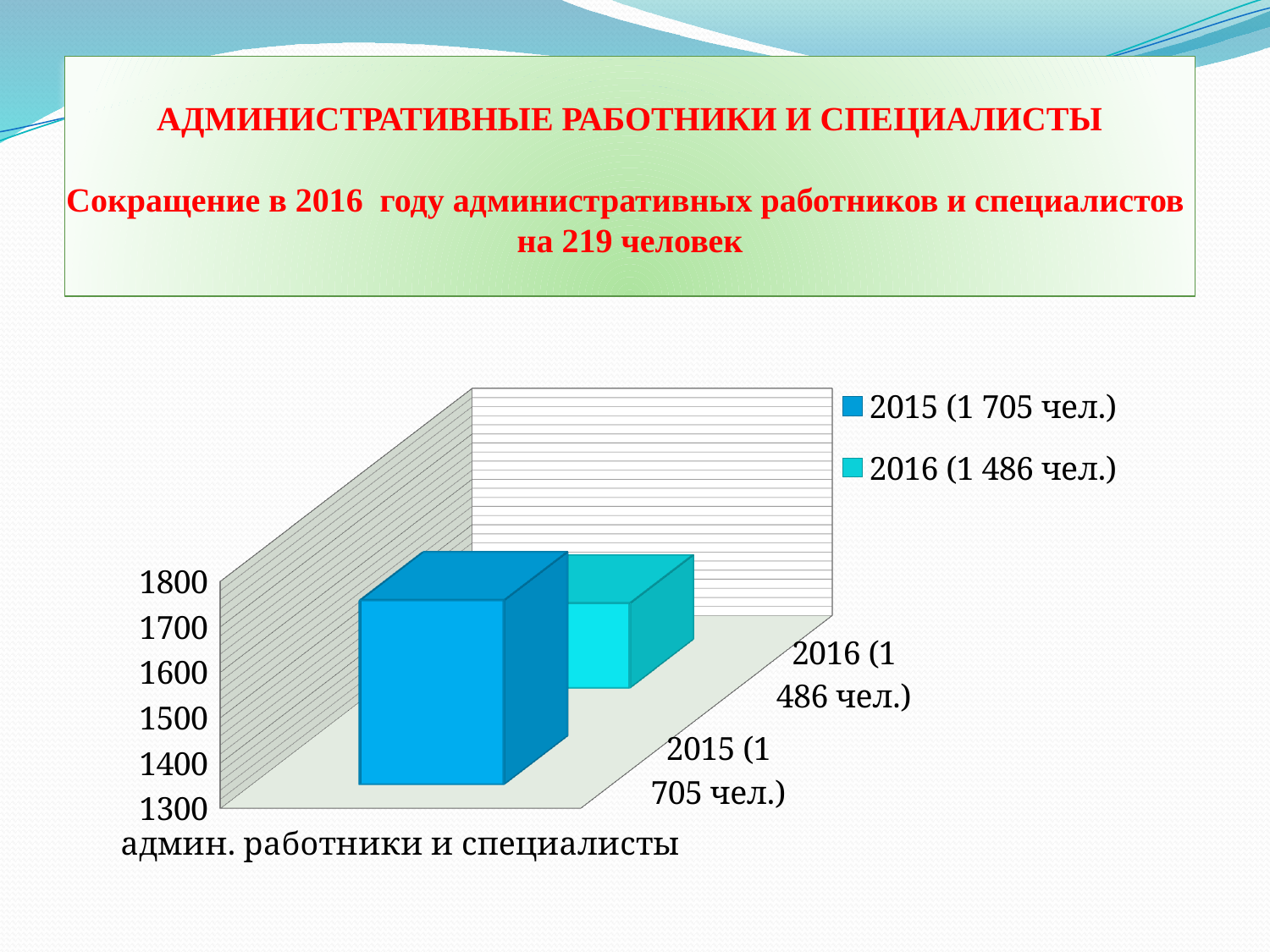
How many series does the chart legend list? 2 Is the value for 2015 greater or less than 1600? greater Which year has the higher value, 2015 or 2016? 2015 According to the legend, how many people were there in 2016? 1 486 чел. What is the lowest value shown on the vertical axis of the chart? 1300 What kind of chart is shown on the slide? bar chart By how many people did the number decrease from 2015 to 2016? 219 According to the legend, how many people were there in 2015? 1 705 чел. How many categories are shown on the x axis of the chart? 1 Which series has the lowest value in the chart? 2016 (1 486 чел.) Which series has the highest value in the chart? 2015 (1 705 чел.) What is the category label shown on the x axis of the chart? админ. работники и специалисты